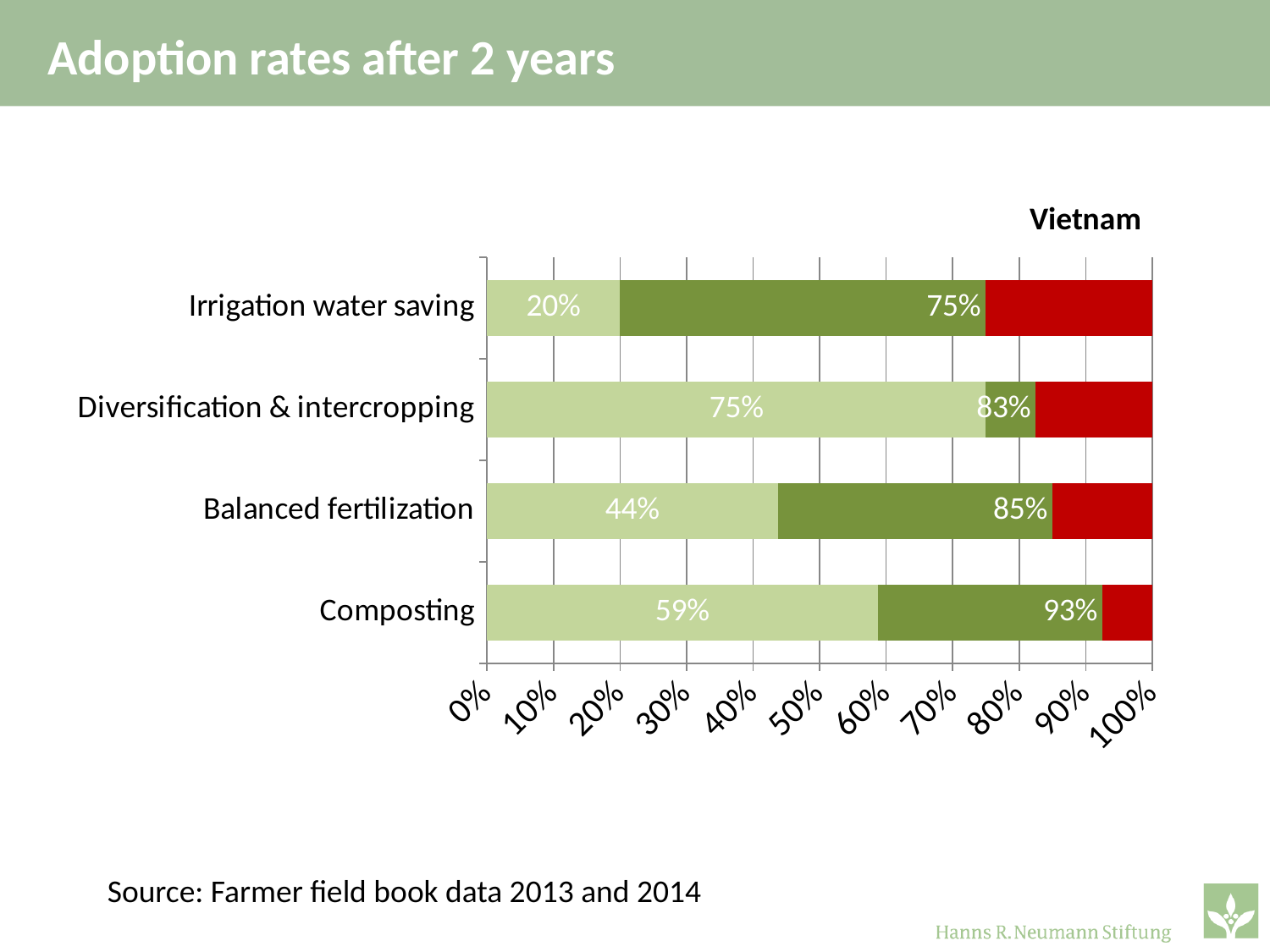
What value is printed on the light green segment for Balanced fertilization? 44% What is the difference between the light green values for Composting and Balanced fertilization? 15% What kind of chart is shown on the slide? Stacked bar chart Is the light green value for Composting greater or less than 50%? greater Which category has the lowest value printed on its light green segment? Irrigation water saving What value is printed on the dark green segment for Composting? 93% Which is larger: the dark green value for Balanced fertilization or for Irrigation water saving? Balanced fertilization What value is printed on the light green segment for Irrigation water saving? 20% Which country is named in the chart's title? Vietnam Which category has the highest value printed on its light green segment? Diversification & intercropping How many categories are shown on the chart? 4 What value is printed on the dark green segment for Diversification & intercropping? 83%